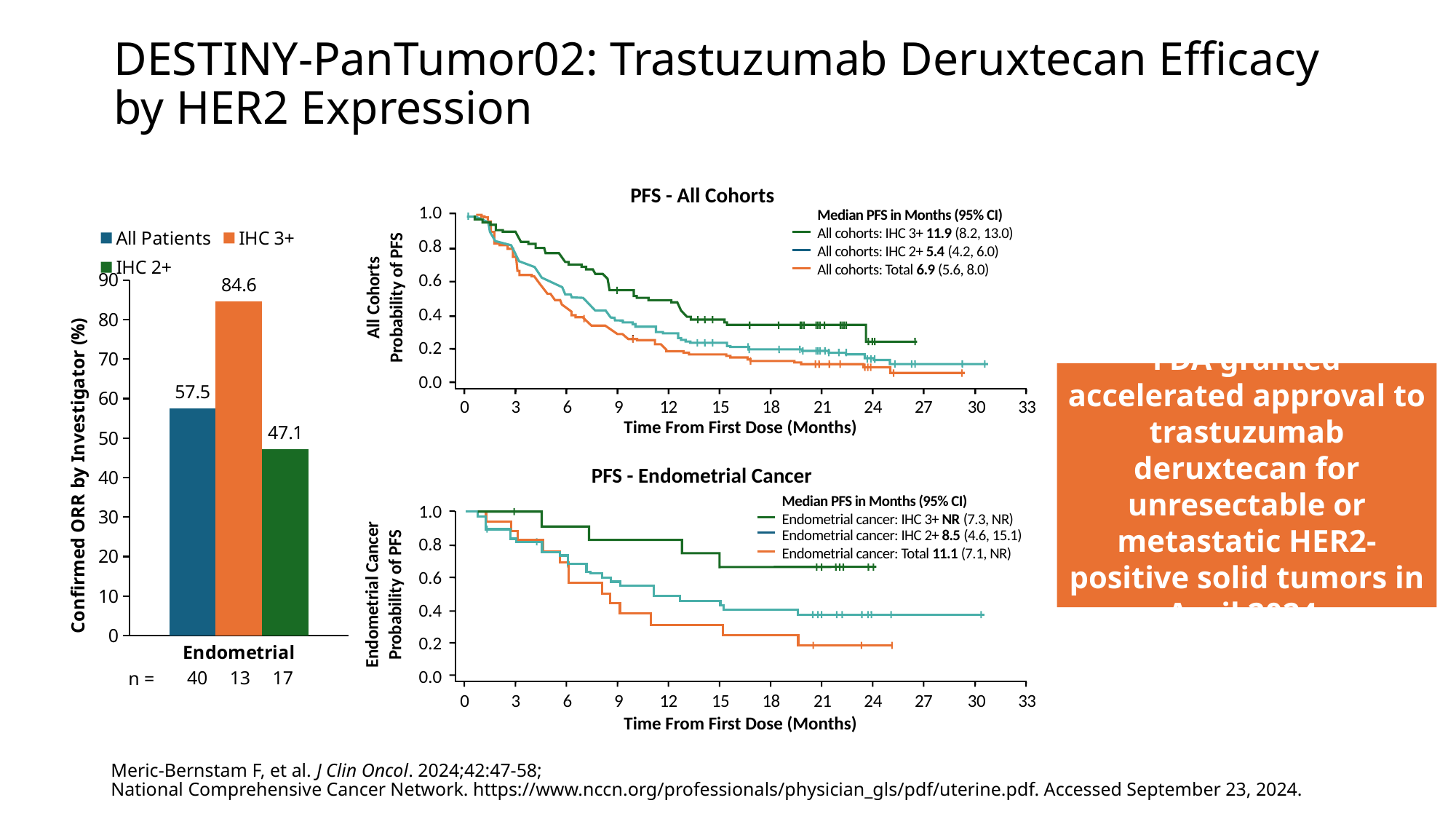
In the PFS - All Cohorts chart, which group has the longer median PFS, IHC 3+ or IHC 2+? IHC 3+ What kind of chart is the confirmed ORR by investigator chart on the left? Bar chart In the bar chart of confirmed ORR by investigator, what is the ORR for IHC 2+ patients? 47.1 In the PFS - Endometrial Cancer chart, what is the median PFS in months for IHC 2+? 8.5 In the bar chart of confirmed ORR by investigator, which group has the highest ORR? IHC 3+ In the PFS - All Cohorts chart, what is the median PFS in months for IHC 3+? 11.9 In the bar chart of confirmed ORR by investigator, which group has the lowest ORR? IHC 2+ In the bar chart of confirmed ORR by investigator, what is the ORR for All Patients with endometrial cancer? 57.5 In the bar chart of confirmed ORR by investigator, how many series does the legend list? 3 In the bar chart of confirmed ORR by investigator, what is the difference in ORR between IHC 3+ and IHC 2+? 37.5 In the bar chart of confirmed ORR by investigator, what is the ORR for IHC 3+ patients with endometrial cancer? 84.6 In the bar chart of confirmed ORR by investigator, how many patients (n) are in the IHC 3+ group? 13